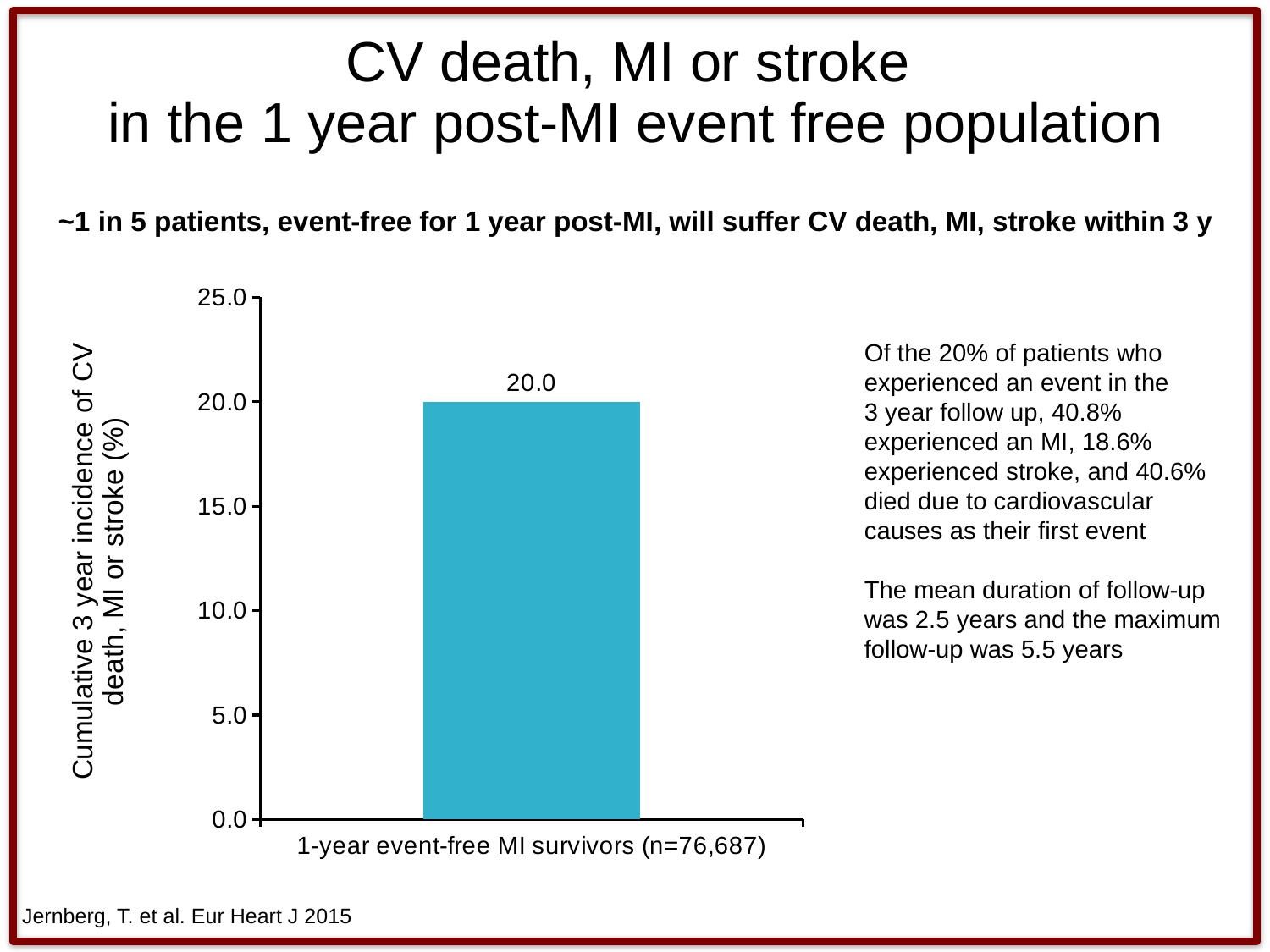
How many bars are plotted in the chart? 1 What kind of chart is shown on the slide? bar chart What is the category label on the x axis of the chart? 1-year event-free MI survivors (n=76,687) Is the value for 1-year event-free MI survivors greater or less than 15.0? greater What is the maximum value shown on the y axis of the chart? 25.0 Is the value for 1-year event-free MI survivors greater or less than 25.0? less What is the value shown for 1-year event-free MI survivors (n=76,687)? 20.0 What is the label on the y axis of the chart? Cumulative 3 year incidence of CV death, MI or stroke (%)